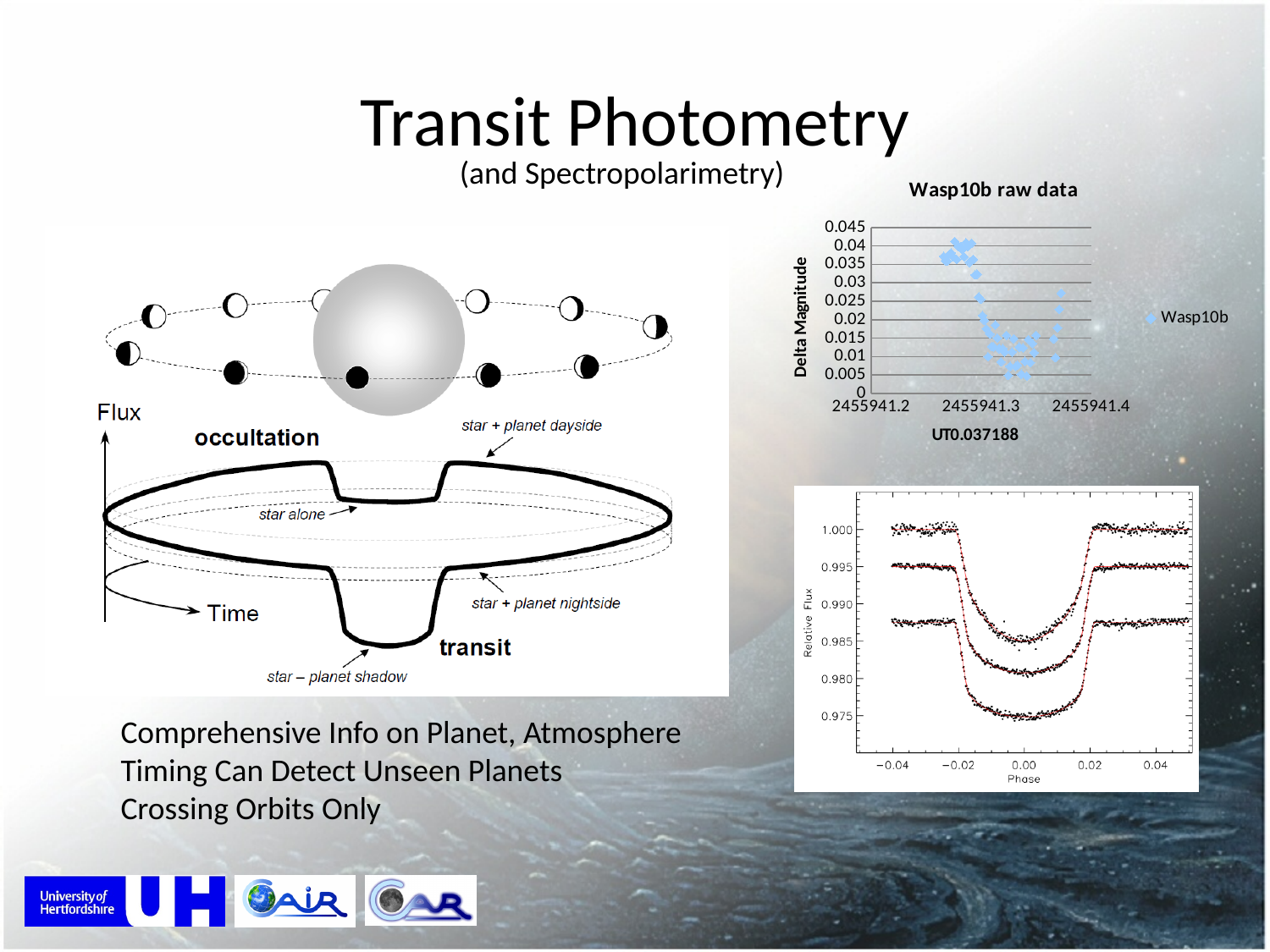
What is the title of the chart in the upper right of the slide? Wasp10b raw data How many series does the legend of the 'Wasp10b raw data' chart list? 1 What is the lowest value shown on the y axis of the 'Wasp10b raw data' chart? 0 What is the name of the series shown in the legend of the 'Wasp10b raw data' chart? Wasp10b What is the rightmost tick label on the x axis of the 'Wasp10b raw data' chart? 2455941.4 In the 'Wasp10b raw data' chart, are the earliest (leftmost) data points greater or less than 0.03 in Delta Magnitude? greater What is the leftmost tick label on the x axis of the 'Wasp10b raw data' chart? 2455941.2 What is the highest value shown on the y axis of the 'Wasp10b raw data' chart? 0.045 In the 'Wasp10b raw data' chart, do the Delta Magnitude values generally rise or fall as you move from left to right along the x axis? fall What kind of chart is the 'Wasp10b raw data' chart? scatter chart